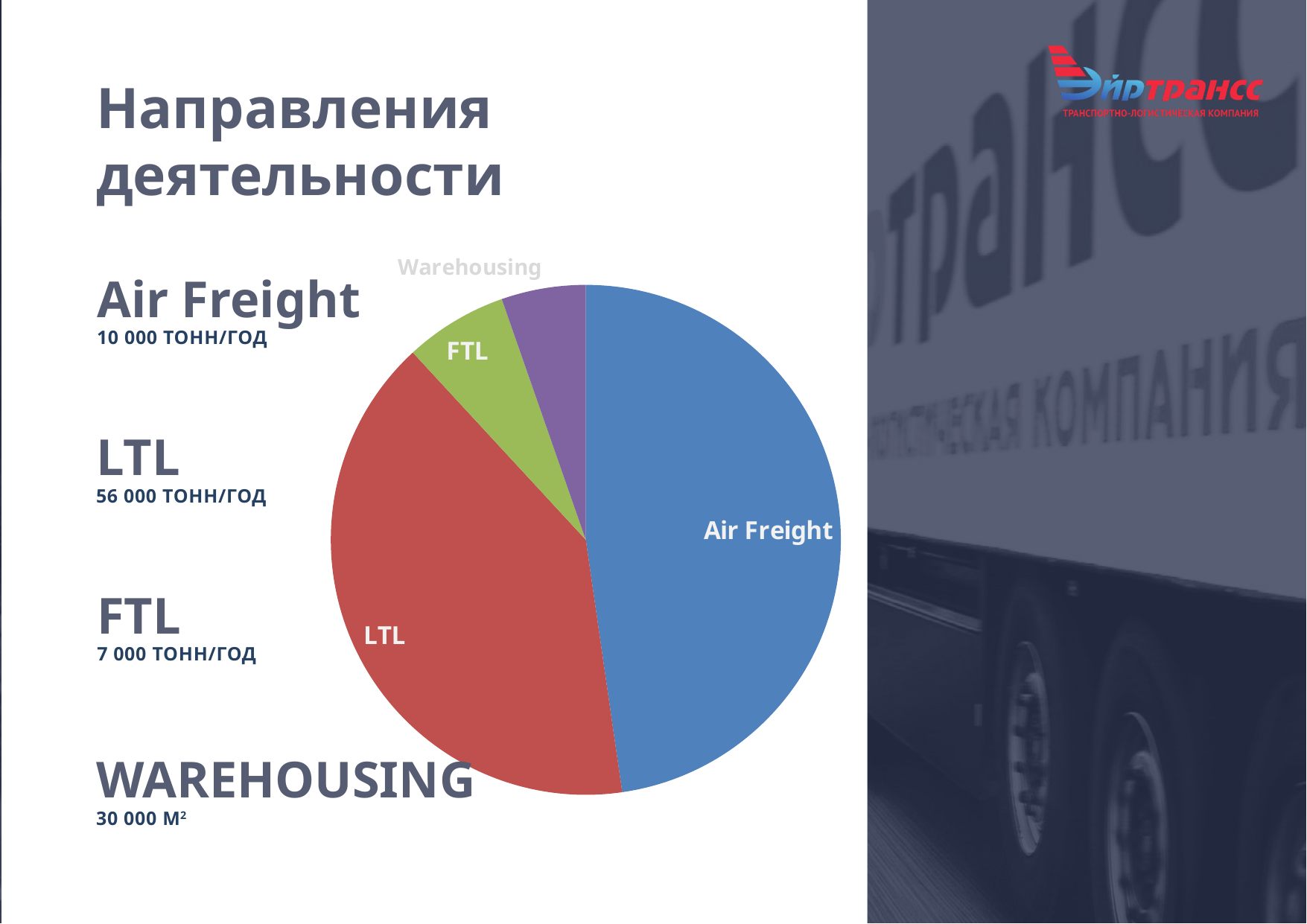
Which category has the largest slice in the pie chart? Air Freight Which category has the smallest slice in the pie chart? Warehousing Which slice is larger in the pie chart, LTL or FTL? LTL Which slice is larger in the pie chart, FTL or Warehousing? FTL What kind of chart is shown on the slide? pie chart How many slices does the pie chart have? 4 Which category is shown by the purple slice in the pie chart? Warehousing What colour is the LTL slice in the pie chart? red Which slice is larger in the pie chart, Air Freight or LTL? Air Freight